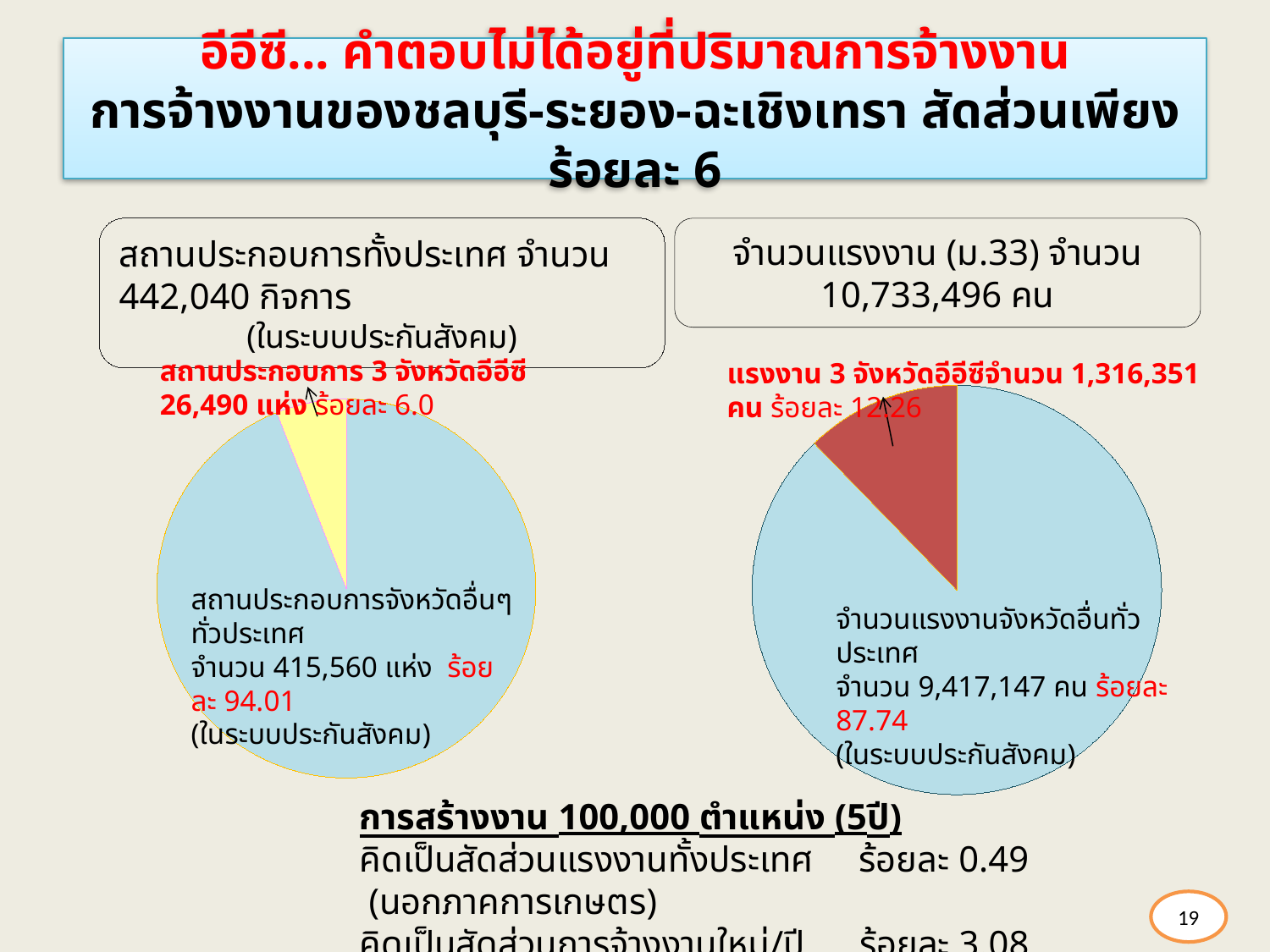
In the right pie chart, how many workers are in the 3 EEC provinces (แรงงาน 3 จังหวัดอีอีซี)? 1,316,351 คน In the right pie chart, what percentage share do workers in other provinces have? ร้อยละ 87.74 What type of chart is shown on the right side of the slide? pie chart In the left pie chart, what percentage share do establishments in other provinces have? ร้อยละ 94.01 In the right pie chart, which slice is larger: workers in the 3 EEC provinces or workers in other provinces? workers in other provinces (จำนวนแรงงานจังหวัดอื่นทั่วประเทศ) In the left pie chart, how many establishments are in the 3 EEC provinces (สถานประกอบการ 3 จังหวัดอีอีซี)? 26,490 แห่ง In the left pie chart, what percentage share do the 3 EEC provinces' establishments have? ร้อยละ 6.0 In the right pie chart, how many workers are in other provinces nationwide (จำนวนแรงงานจังหวัดอื่นทั่วประเทศ)? 9,417,147 คน How many slices does the left pie chart have? 2 What type of chart is shown on the left side of the slide? pie chart In the left pie chart, how many establishments are in other provinces nationwide (สถานประกอบการจังหวัดอื่นๆ ทั่วประเทศ)? 415,560 แห่ง